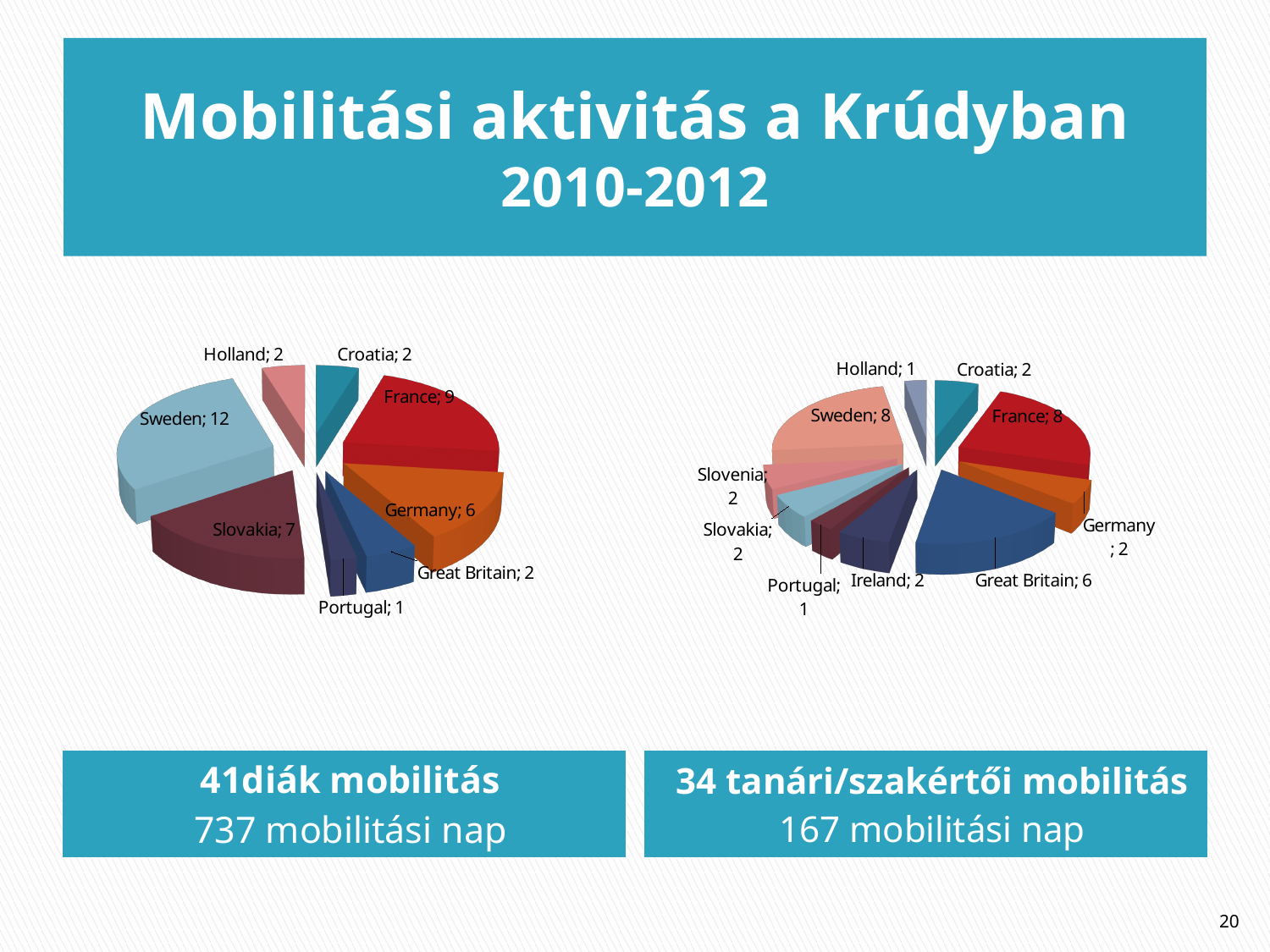
On the left pie chart, which country has the largest slice? Sweden On the left pie chart, which country has the smallest slice? Portugal What kind of chart is shown on the left of the slide? Pie chart How many slices does the left pie chart have? 8 On the right pie chart, what is the value for Holland? 1 On the left pie chart, what is the value for Slovakia? 7 On the right pie chart, which is larger, the value for France or the value for Great Britain? France How many slices does the right pie chart have? 10 On the right pie chart, what is the value for Great Britain? 6 On the left pie chart, what is the value for Sweden? 12 On the left pie chart, what is the difference between the values for France and Germany? 3 On the right pie chart, which country has the smallest slice? Holland and Portugal (both 1)